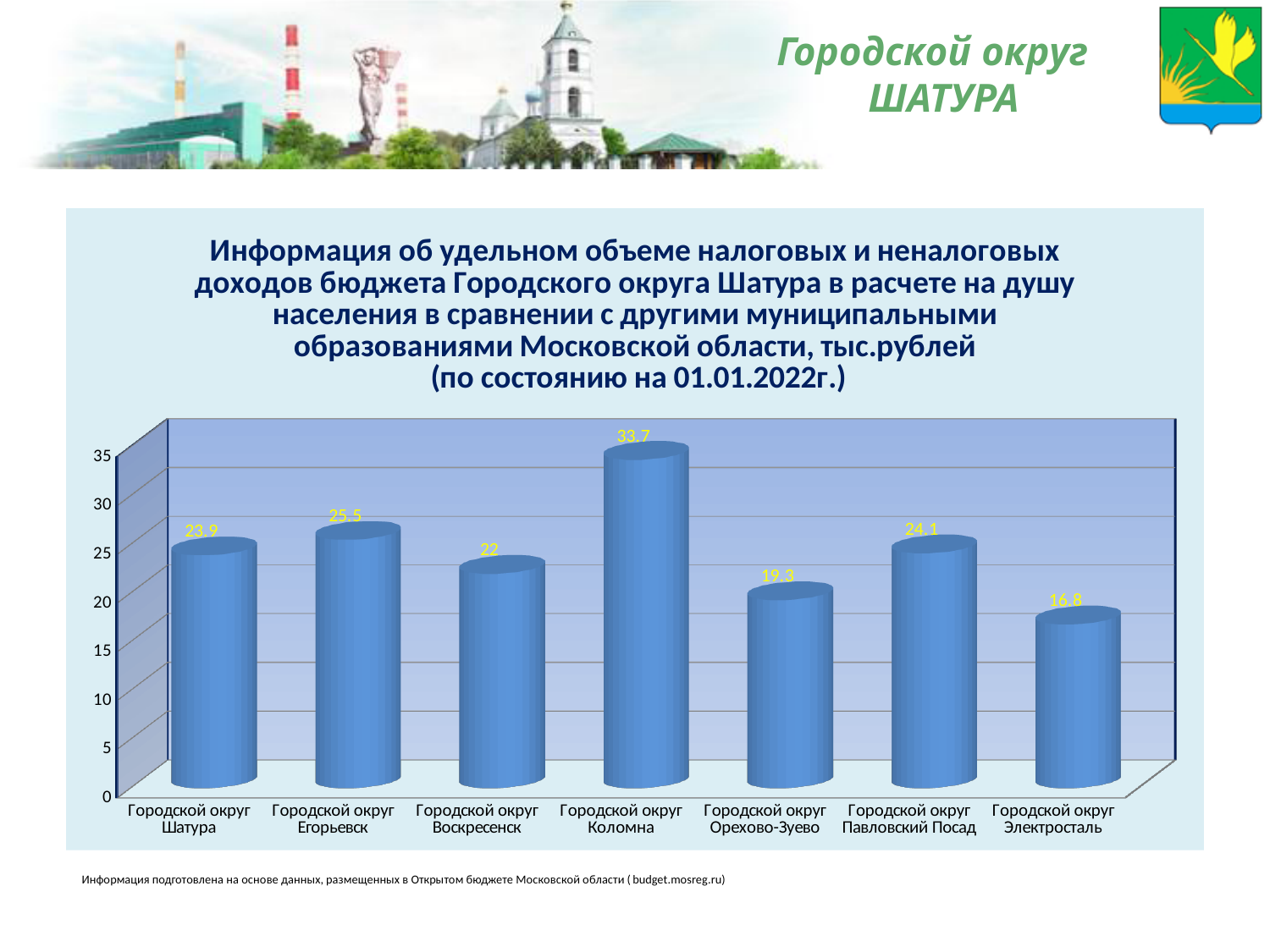
What is the value for Городской округ Павловский Посад? 24.1 What kind of chart is shown on the slide? bar chart What is the value for Городской округ Шатура? 23.9 Which category has the lowest value? Городской округ Электросталь Which is larger, the value for Городской округ Егорьевск or Городской округ Павловский Посад? Городской округ Егорьевск What is the value for Городской округ Воскресенск? 22 How many categories are shown on the chart? 7 Which category has the highest value? Городской округ Коломна What is the difference between the values for Городской округ Коломна and Городской округ Шатура? 9.8 What is the value for Городской округ Электросталь? 16.8 What is the value for Городской округ Коломна? 33.7 Is the value for Городской округ Орехово-Зуево greater or less than 20? less